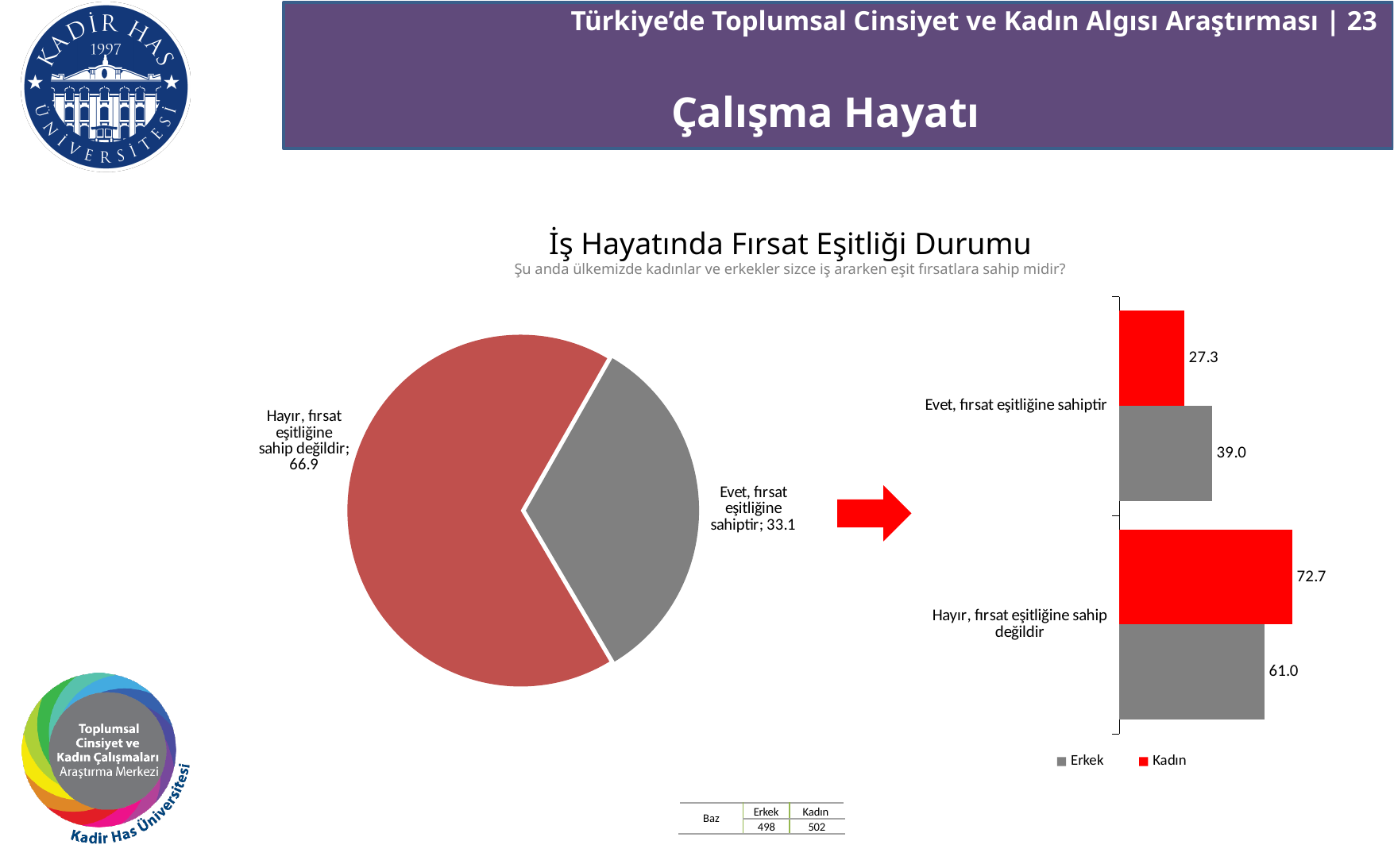
In the pie chart on the left, what is the value for "Hayır, fırsat eşitliğine sahip değildir"? 66.9 How many series does the legend of the bar chart on the right list? 2 In the bar chart on the right, which colour represents the Kadın series? Red In the bar chart on the right, what is the Erkek value for "Hayır, fırsat eşitliğine sahip değildir"? 61.0 In the pie chart on the left, how many slices are there? 2 In the bar chart on the right, what is the difference between the Kadın and Erkek values for "Hayır, fırsat eşitliğine sahip değildir"? 11.7 In the bar chart on the right, what is the Kadın value for "Evet, fırsat eşitliğine sahiptir"? 27.3 In the bar chart on the right, which bar has the highest value? Kadın, Hayır, fırsat eşitliğine sahip değildir (72.7) What kind of chart is the chart on the left of the slide? Pie chart In the bar chart on the right, which is larger for "Evet, fırsat eşitliğine sahiptir": the Erkek value or the Kadın value? Erkek In the pie chart on the left, which slice is the largest? Hayır, fırsat eşitliğine sahip değildir In the pie chart on the left, what is the value for "Evet, fırsat eşitliğine sahiptir"? 33.1